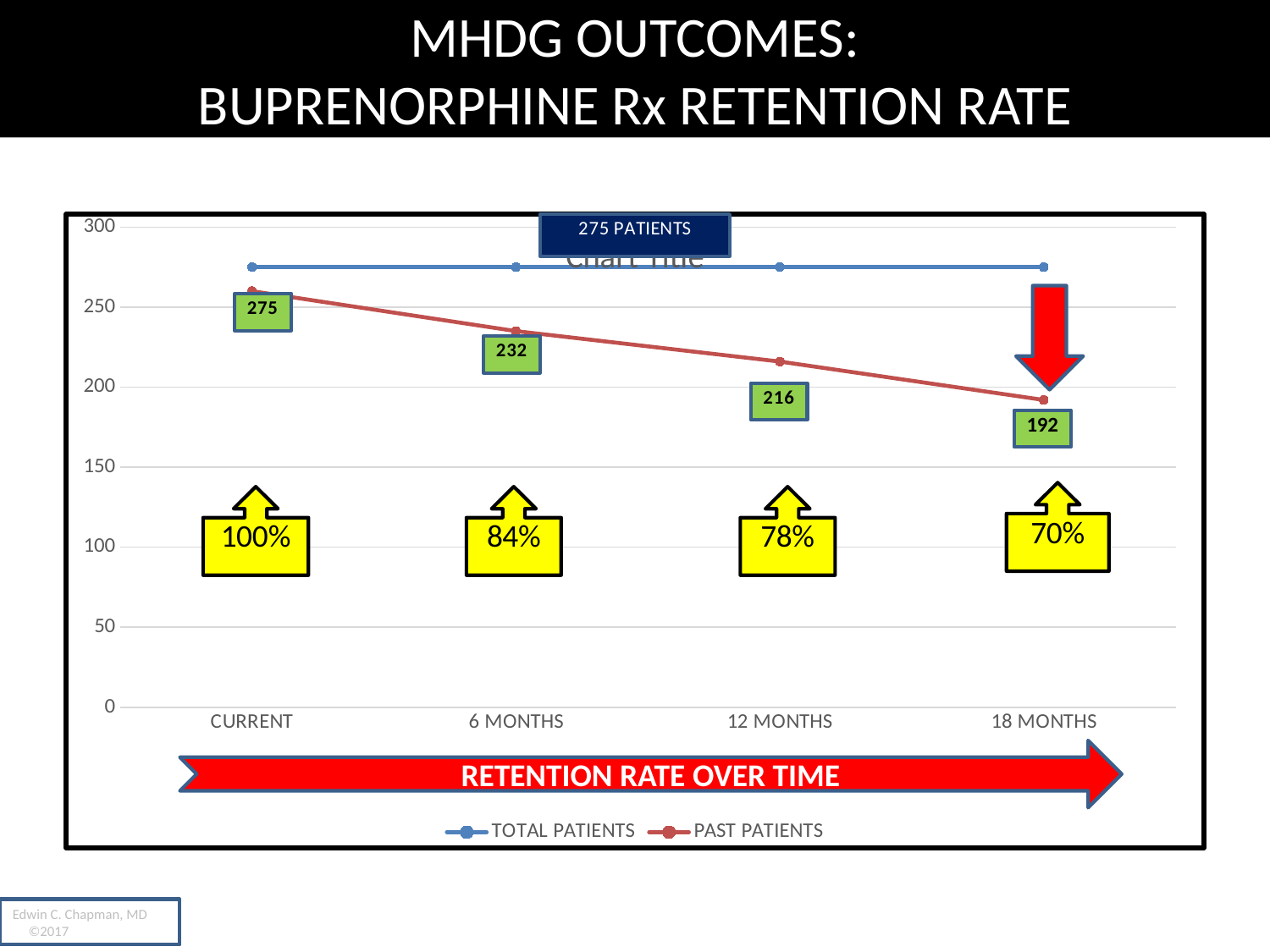
Which is larger at 12 MONTHS, TOTAL PATIENTS or PAST PATIENTS? TOTAL PATIENTS Is the value for TOTAL PATIENTS at 12 MONTHS greater or less than 250? greater What kind of chart is shown on the slide? line chart How many series does the legend list? 2 What is the difference between the PAST PATIENTS values at 6 MONTHS and 18 MONTHS? 40 Do the PAST PATIENTS values rise or fall from CURRENT to 18 MONTHS? fall What is the value for PAST PATIENTS at 6 MONTHS? 232 How many time points are shown on the x axis? 4 What is the value for PAST PATIENTS at 18 MONTHS? 192 What retention rate percentage is shown for 18 MONTHS? 70% What is the value for PAST PATIENTS at 12 MONTHS? 216 At which time point is the PAST PATIENTS value lowest? 18 MONTHS